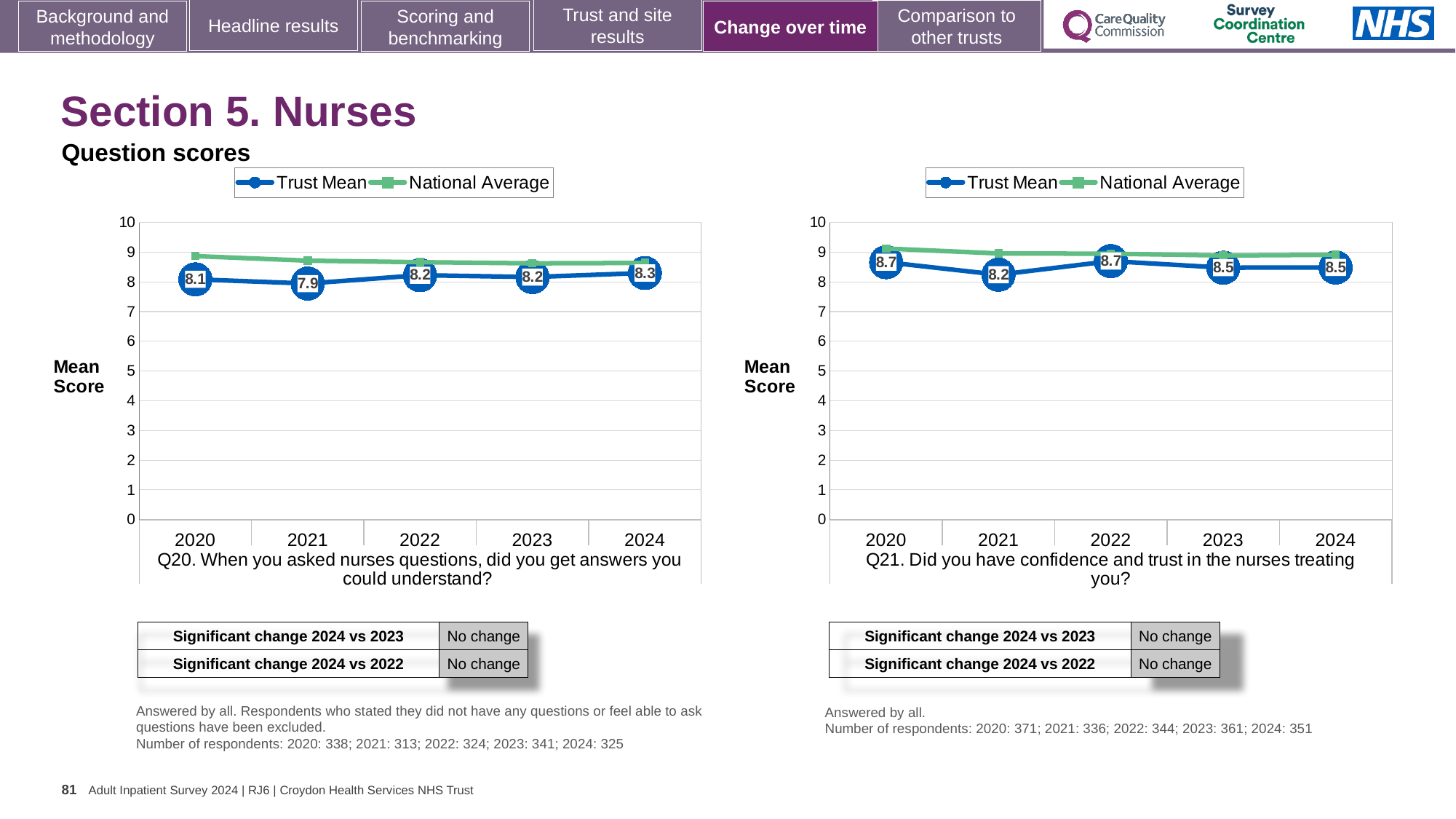
In the Q21 chart on the right, what is the Trust Mean score for 2023? 8.5 In the Q20 chart on the left, what is the Trust Mean score for 2021? 7.9 In the Q21 chart on the right, which year has the lowest Trust Mean score? 2021 In the Q21 chart on the right, what is the difference between the Trust Mean scores for 2020 and 2021? 0.5 In the Q20 chart on the left, is the Trust Mean score for 2022 greater or less than the Trust Mean score for 2021? greater How many years are shown on the x axis of the Q20 chart on the left? 5 In the Q21 chart on the right, is the National Average value for 2020 greater or less than 8? greater In the Q21 chart on the right, what is the Trust Mean score for 2020? 8.7 In the Q20 chart on the left, what is the Trust Mean score for 2024? 8.3 In the Q20 chart on the left, which year has the lowest Trust Mean score? 2021 How many series does the legend of the Q21 chart on the right list? 2 In the Q20 chart on the left, which year has the highest Trust Mean score? 2024